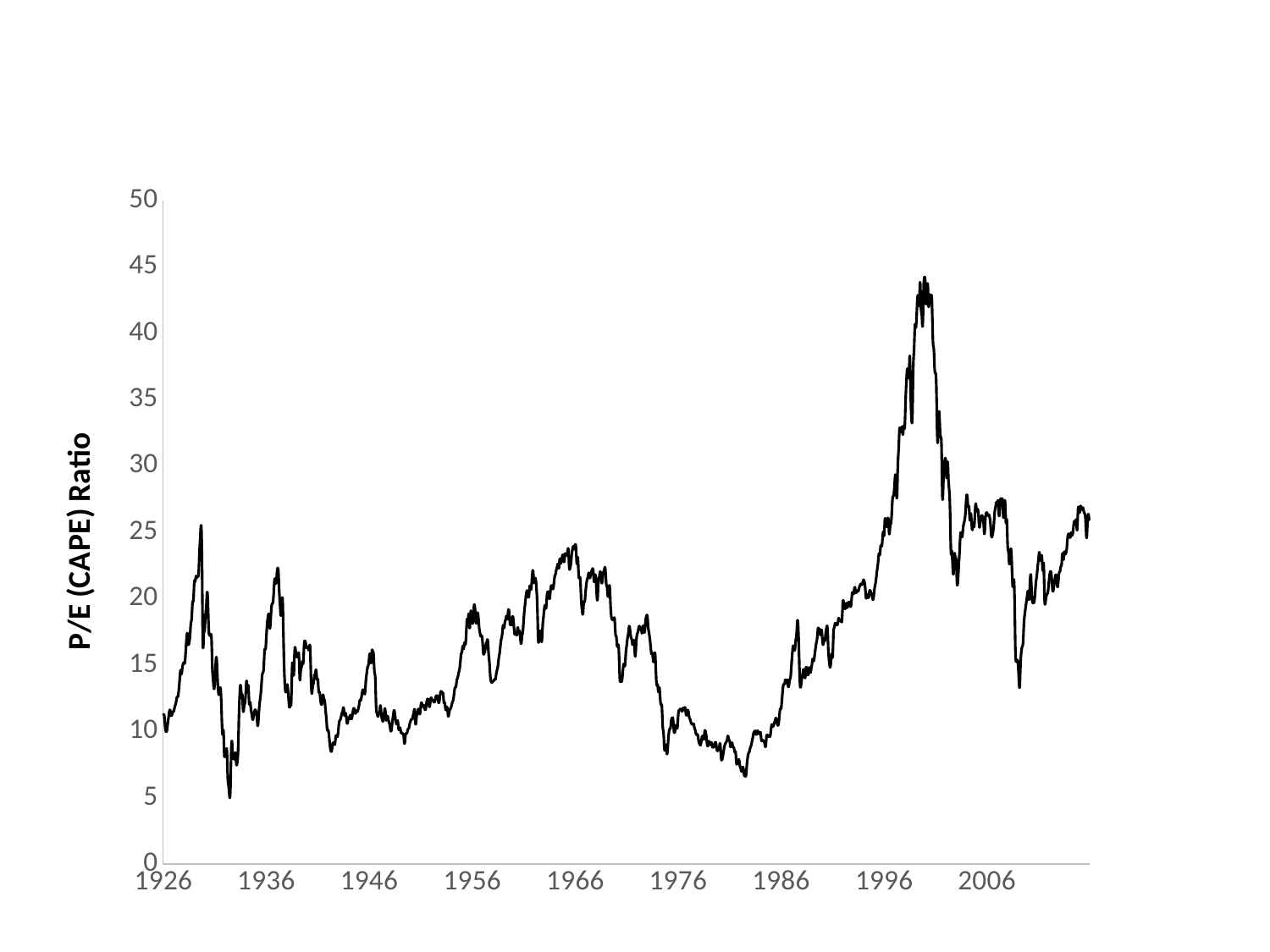
Is the value at the start of the series in 1926 greater or less than 15? less Is the value around 1966 greater or less than 20? greater How many year labels are shown on the horizontal axis? 9 Does the line generally rise or fall between 1986 and 2000? rise Is the peak value of the line, reached around 2000, greater or less than 40? greater What is the highest value shown on the vertical axis? 50 What is the label on the vertical axis? P/E (CAPE) Ratio Does the line generally rise or fall between 1966 and 1982? fall What kind of chart is shown on the slide? line chart